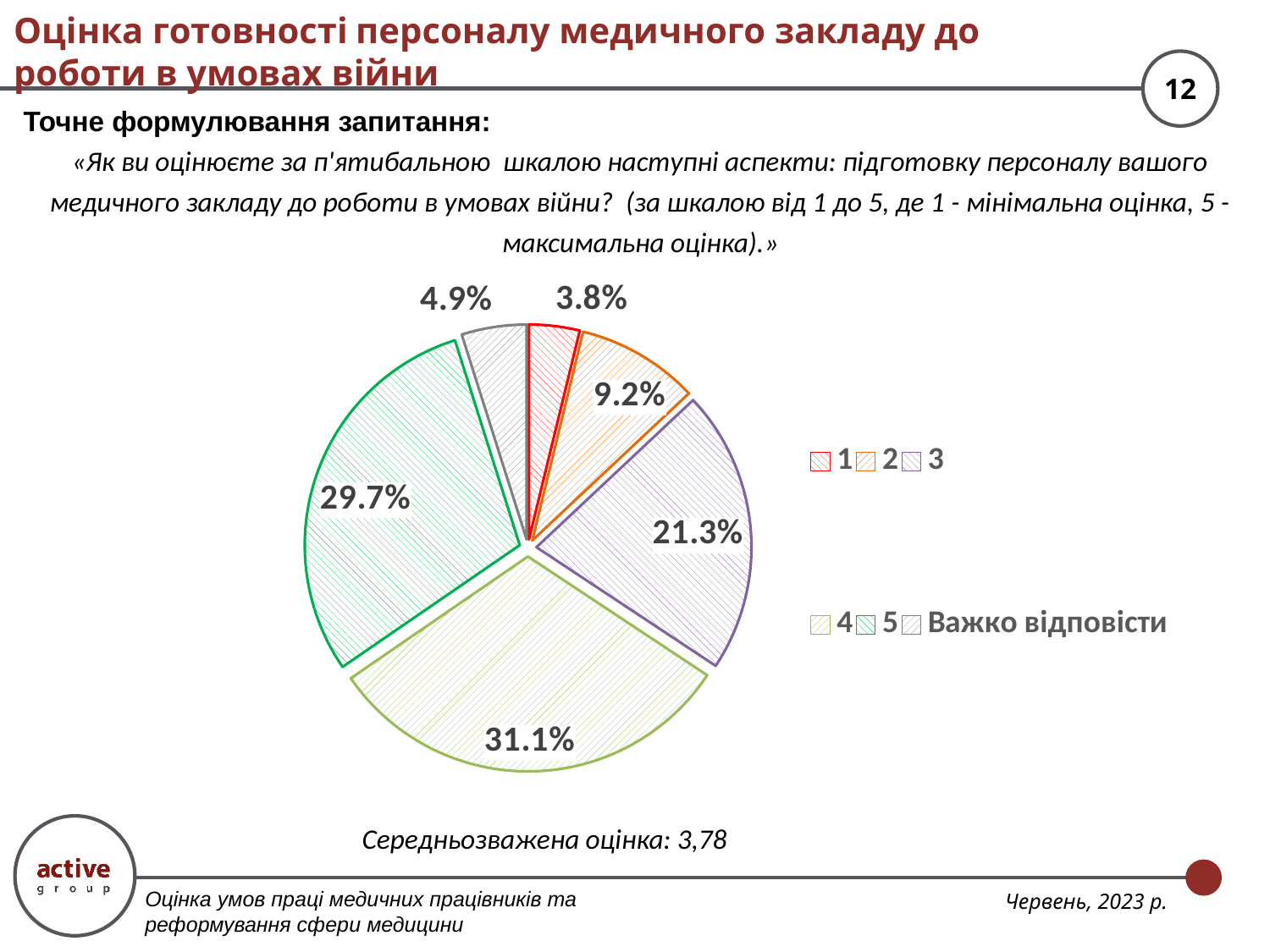
Which category has the smallest share of the pie? 1 What percentage of respondents gave a rating of 1? 3.8% Which is larger: the share for rating 5 or the share for rating 3? 5 What percentage of respondents gave a rating of 4? 31.1% What weighted average score is stated below the chart? 3,78 What type of chart is shown on the slide? pie chart What percentage of respondents gave a rating of 5? 29.7% What percentage of respondents answered "Важко відповісти"? 4.9% What is the combined share of ratings 4 and 5? 60.8% Which rating category has the largest share of the pie? 4 How many categories does the legend list? 6 What is the difference between the share for rating 3 and the share for rating 2? 12.1%